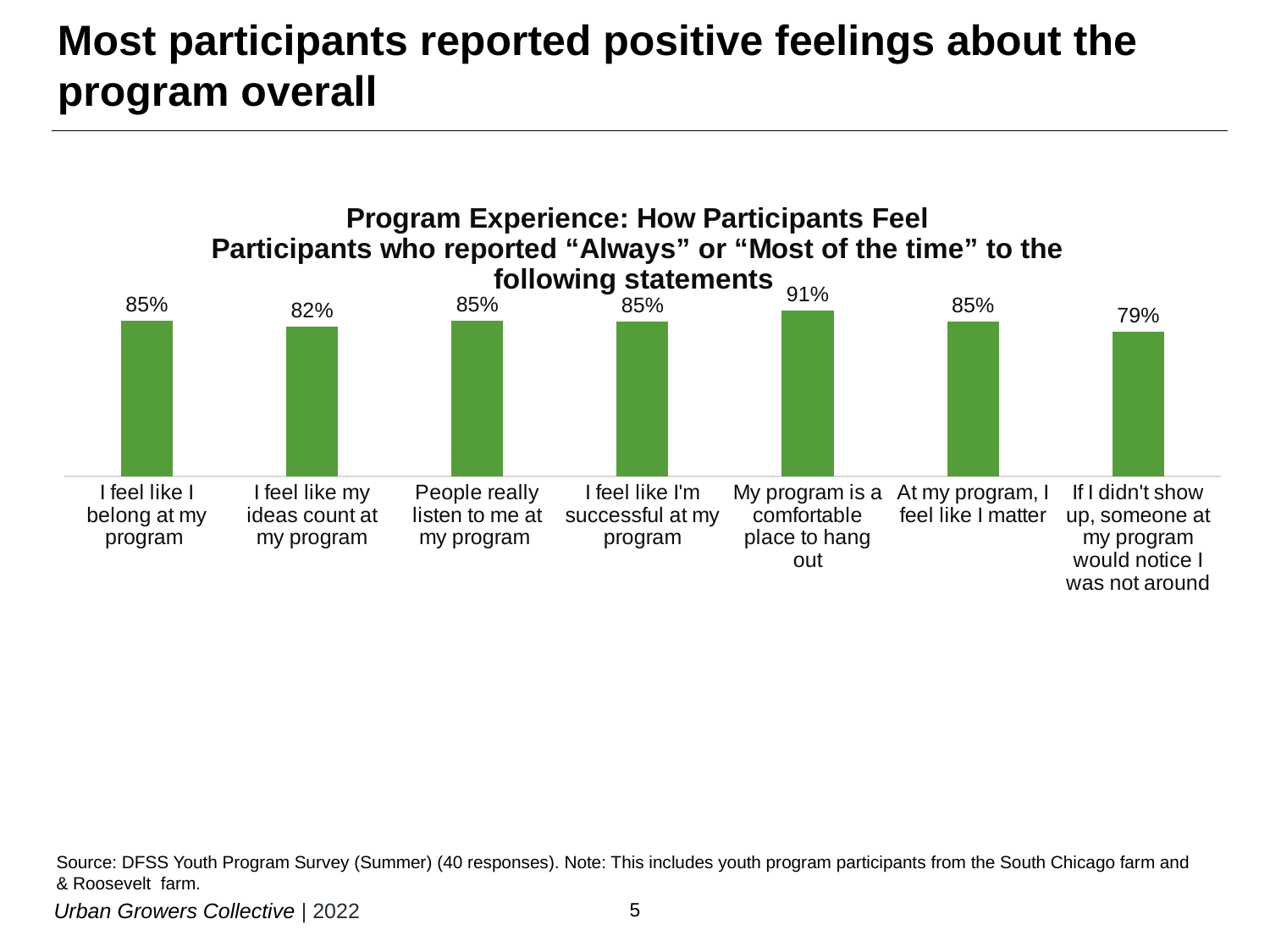
What type of chart is shown on the slide? Bar chart How many statements have a value of exactly 85%? 4 What is the value for "I feel like my ideas count at my program"? 82% Which statement has the lowest percentage? If I didn't show up, someone at my program would notice I was not around What is the value for "If I didn't show up, someone at my program would notice I was not around"? 79% What percentage of participants reported "Always" or "Most of the time" for "I feel like I belong at my program"? 85% What is the difference between the highest and lowest percentages shown? 12 percentage points What is the value for "My program is a comfortable place to hang out"? 91% What is the difference between "I feel like I belong at my program" and "I feel like my ideas count at my program"? 3 percentage points How many statements are shown in the chart? 7 Which statement has the highest percentage? My program is a comfortable place to hang out Which is larger: the value for "At my program, I feel like I matter" or the value for "I feel like my ideas count at my program"? At my program, I feel like I matter